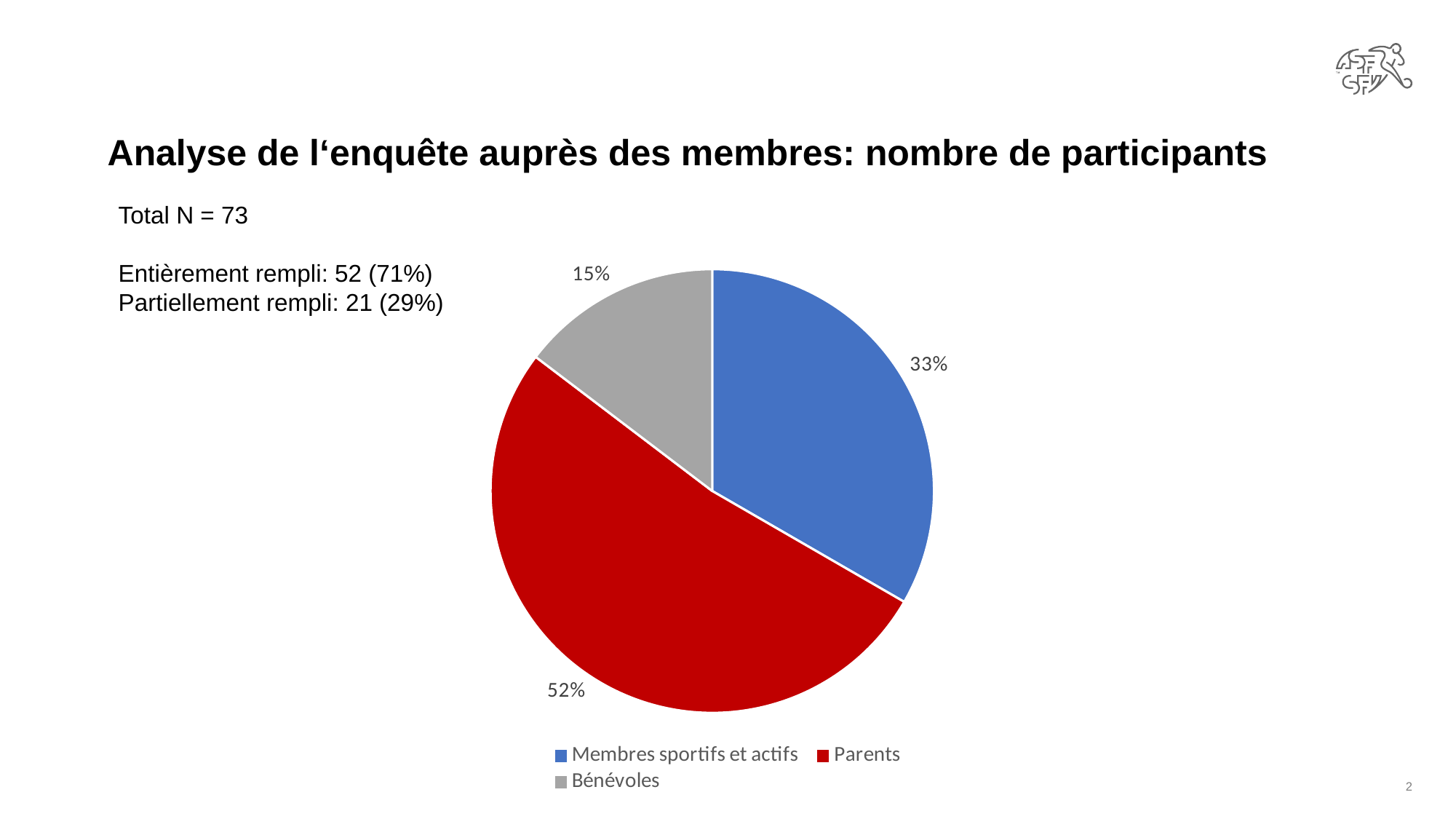
What share of the pie does Membres sportifs et actifs represent? 33% What share of the pie does Parents represent? 52% Which category is shown in grey in the legend? Bénévoles What colour is the Parents slice? red How many categories does the pie chart show? 3 What is the difference in percentage points between the Parents slice and the Membres sportifs et actifs slice? 19 Which category has the smallest slice of the pie? Bénévoles Which slice is larger, Membres sportifs et actifs or Bénévoles? Membres sportifs et actifs Which category has the largest slice of the pie? Parents What share of the pie does Bénévoles represent? 15% What is the difference in percentage points between the Membres sportifs et actifs slice and the Bénévoles slice? 18 What kind of chart is shown on the slide? pie chart